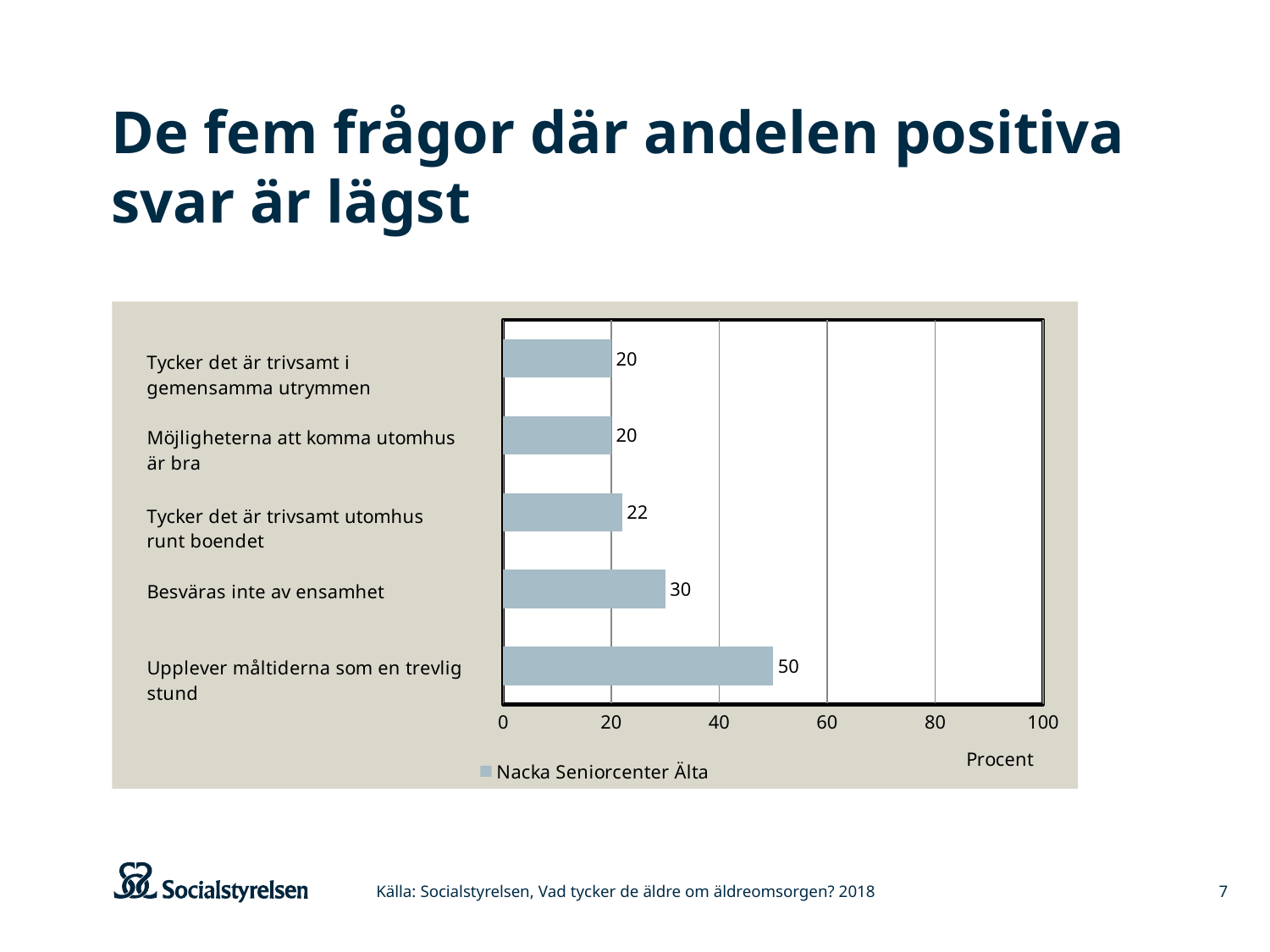
Which category has the highest value? Upplever måltiderna som en trevlig stund How many categories are shown in the chart? 5 What is the value for "Tycker det är trivsamt utomhus runt boendet"? 22 What series name is shown in the legend? Nacka Seniorcenter Älta What kind of chart is shown on the slide? bar chart What is the value for "Upplever måltiderna som en trevlig stund"? 50 What is the label on the horizontal axis? Procent Is the value for "Upplever måltiderna som en trevlig stund" greater or less than 40? greater Which is larger, the value for "Besväras inte av ensamhet" or the value for "Tycker det är trivsamt utomhus runt boendet"? Besväras inte av ensamhet What is the difference between the values for "Upplever måltiderna som en trevlig stund" and "Besväras inte av ensamhet"? 20 How many series does the legend list? 1 What is the value for "Besväras inte av ensamhet"? 30